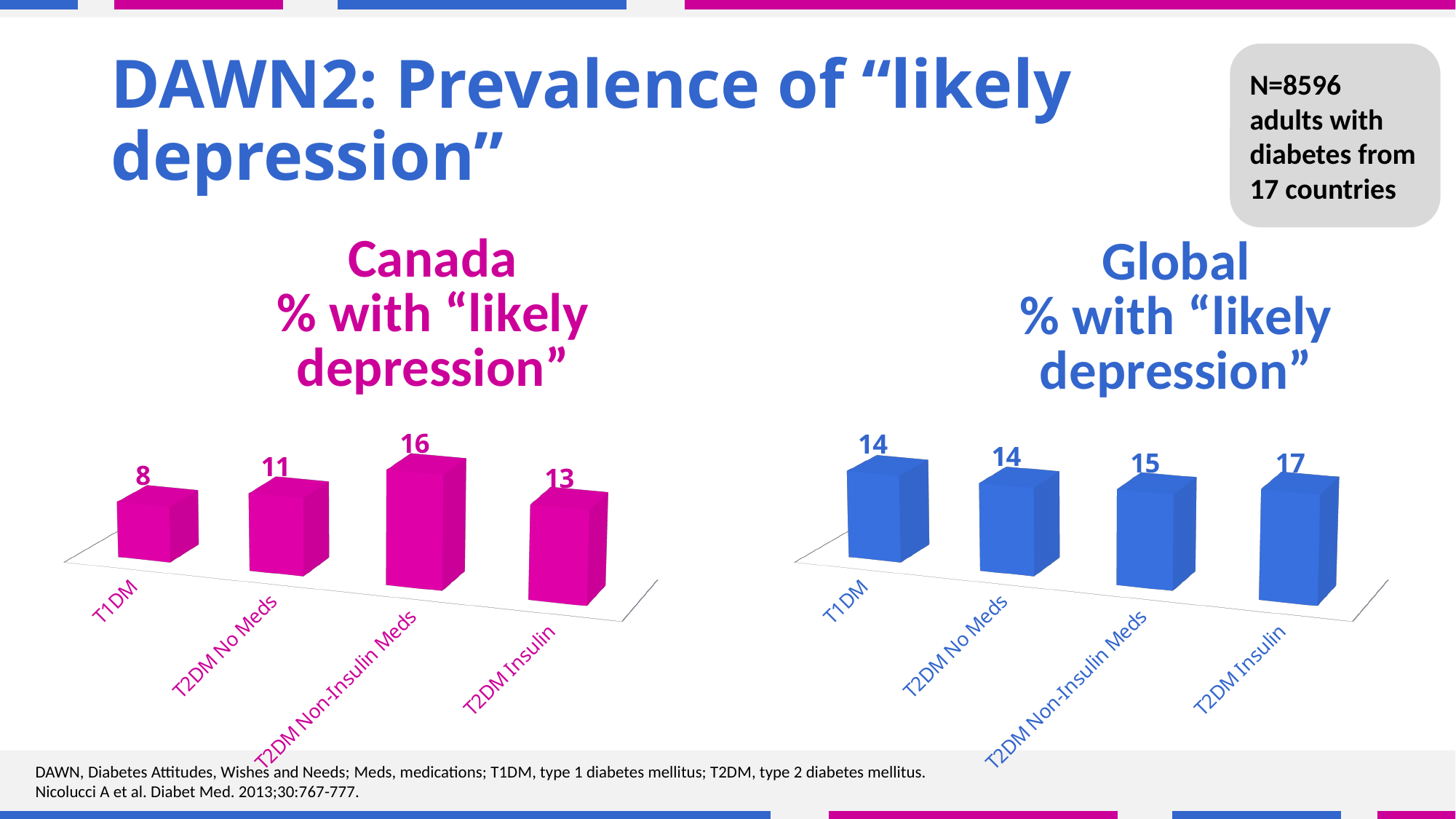
How many categories are shown in the Canada chart? 4 Which is larger: the Canada value for T2DM Insulin or the Global value for T2DM Insulin? Global In the Canada chart, which category has the lowest value? T1DM In the Canada chart, which category has the highest value? T2DM Non-Insulin Meds In the Global chart, what is the value for T2DM Non-Insulin Meds? 15 In the Canada chart, what is the difference between the values for T2DM Non-Insulin Meds and T1DM? 8 What kind of chart is the Global chart? Bar chart In the Canada chart, what is the value for T1DM? 8 In the Canada chart, what is the value for T2DM Non-Insulin Meds? 16 In the Global chart, what is the difference between the values for T2DM Insulin and T2DM No Meds? 3 In the Global chart, what is the value for T2DM Insulin? 17 In the Global chart, which category has the highest value? T2DM Insulin